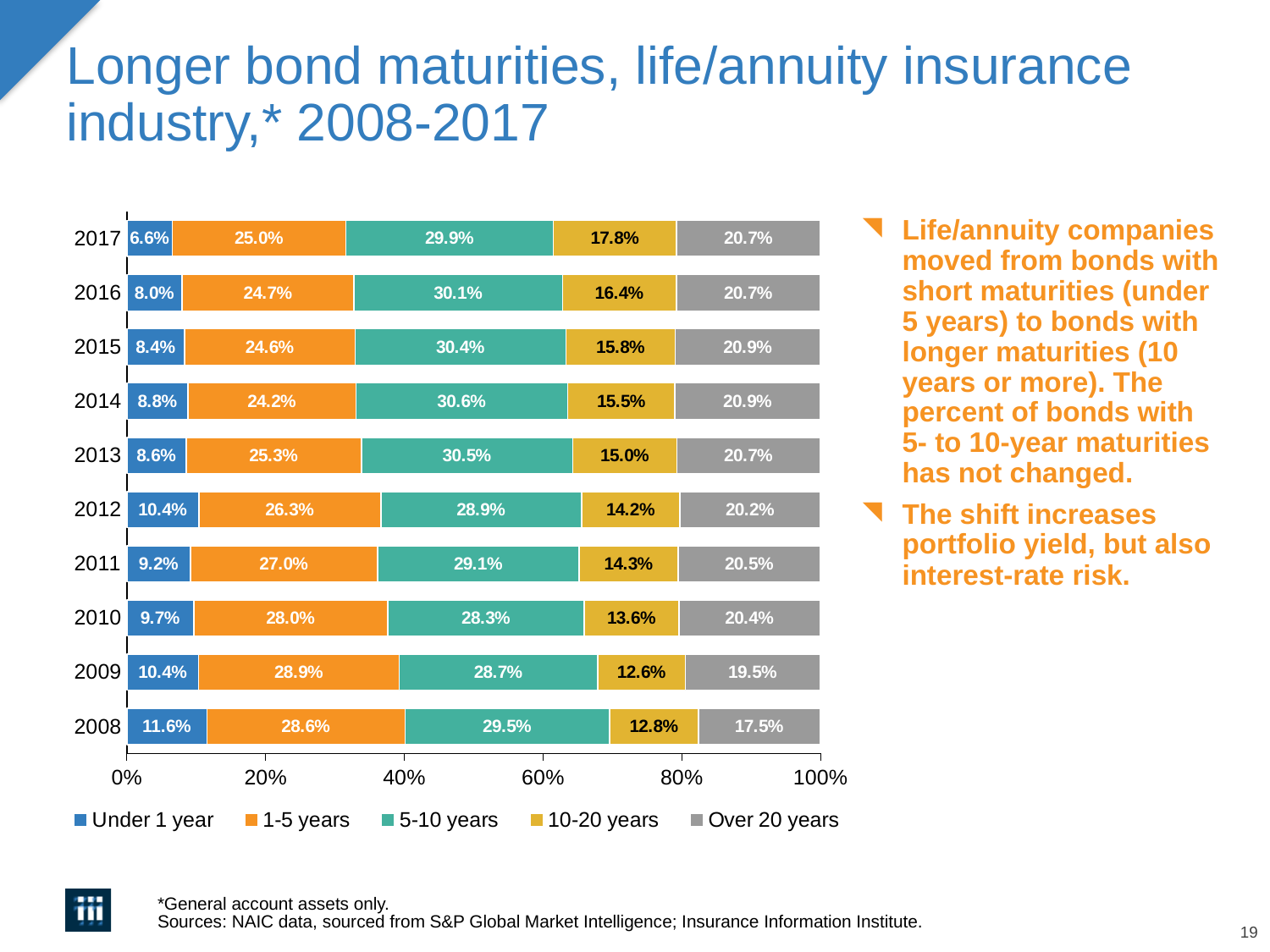
What share of bonds had 1-5 year maturities in 2012? 26.3% What percentage of bonds had maturities under 1 year in 2017? 6.6% In which year was the 10-20 years share the lowest? 2009 How many years are shown on the chart? 10 By how many percentage points did the 10-20 years share in 2017 exceed that in 2008? 5.0 percentage points In which year was the Under 1 year share the highest? 2008 Did the Under 1 year share rise or fall from 2008 to 2017? Fall How many maturity categories does the legend list? 5 What type of chart is shown on the slide? Stacked bar chart In 2017, which was larger: the 1-5 years share or the 5-10 years share? 5-10 years What is the total of the 2017 stacked bar? 100.0% What is the value for Over 20 years in 2008? 17.5%